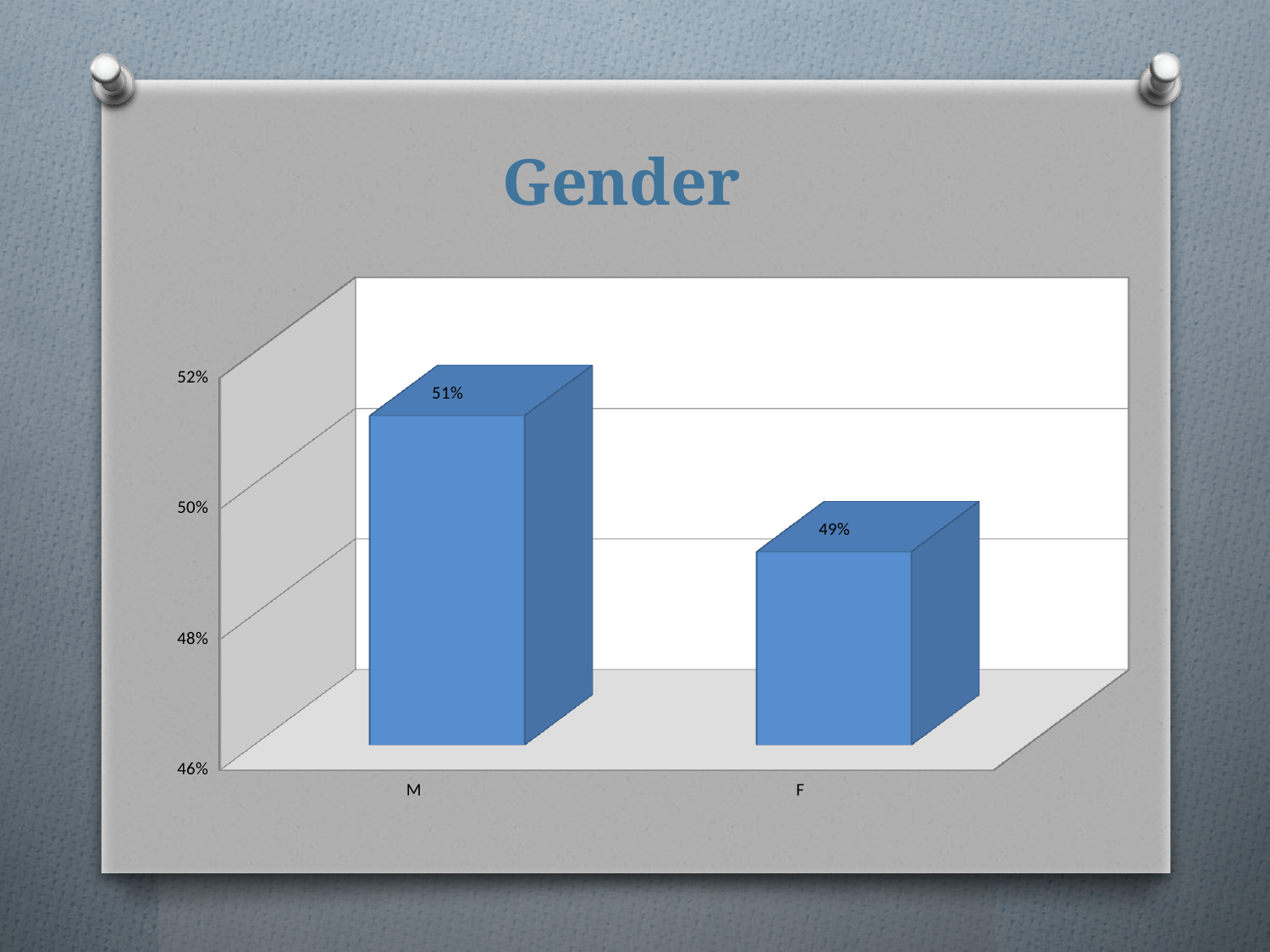
Is the value for F greater or less than 50%? less Is the value for M greater or less than 50%? greater Which category has the lowest value? F What kind of chart is shown on the slide? bar chart What is the difference between the values for M and F? 2% How many categories are shown on the chart? 2 What is the title of the chart? Gender What is the value for M? 51% What is the value for F? 49% Which is larger, the value for M or the value for F? M What is the total of the values for M and F? 100% Which category has the highest value? M